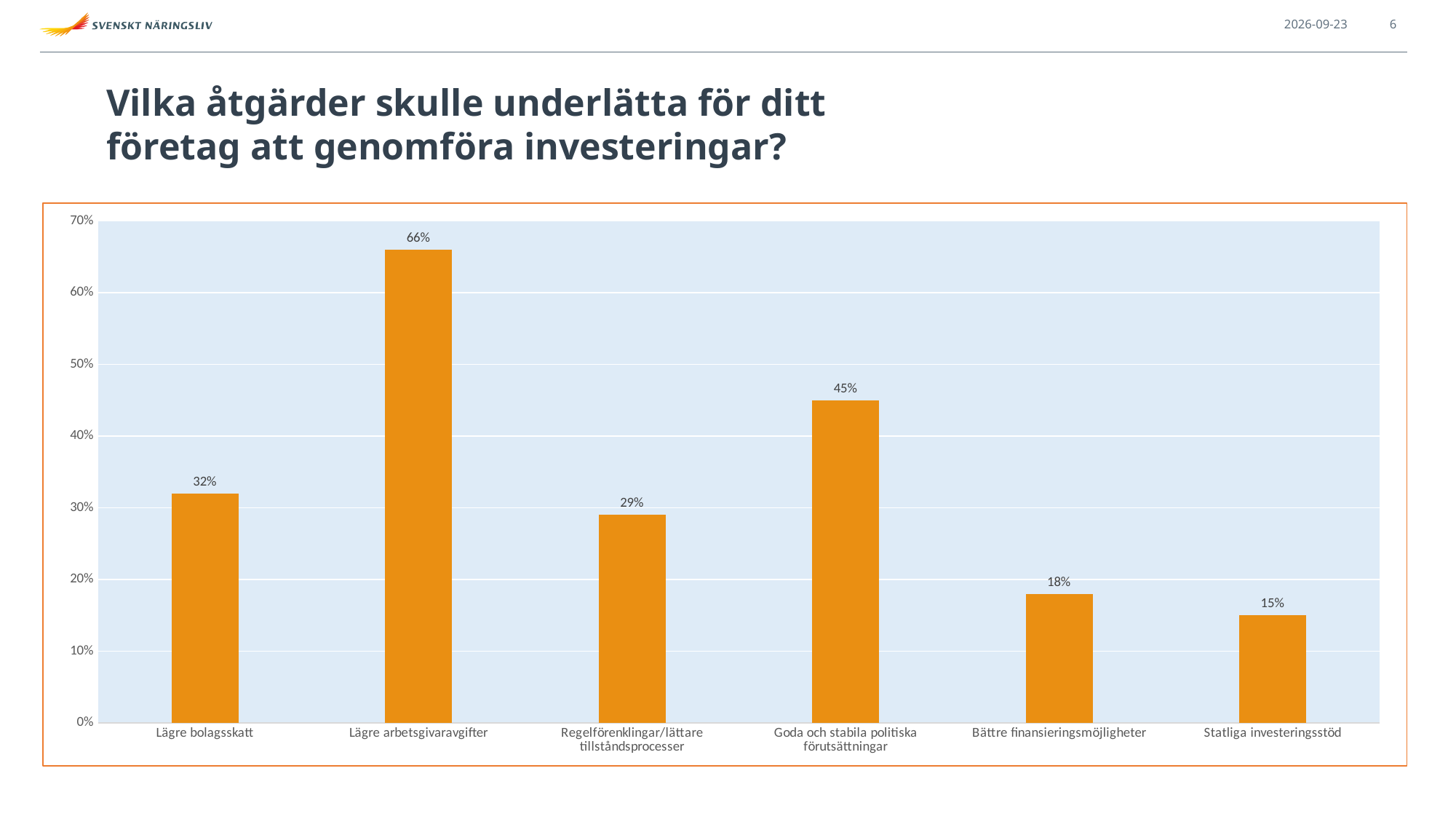
What kind of chart is shown on the slide? Bar chart What is the value for Statliga investeringsstöd? 15% What is the value for Regelförenklingar/lättare tillståndsprocesser? 29% What is the difference between the values for Lägre arbetsgivaravgifter and Lägre bolagsskatt? 34% Which category has the highest value? Lägre arbetsgivaravgifter What is the value for Lägre arbetsgivaravgifter? 66% What is the value for Goda och stabila politiska förutsättningar? 45% How many categories are shown on the x axis? 6 What is the difference between the values for Bättre finansieringsmöjligheter and Statliga investeringsstöd? 3% Which is larger, the value for Lägre bolagsskatt or the value for Regelförenklingar/lättare tillståndsprocesser? Lägre bolagsskatt Is the value for Goda och stabila politiska förutsättningar greater or less than 40%? greater Which category has the lowest value? Statliga investeringsstöd